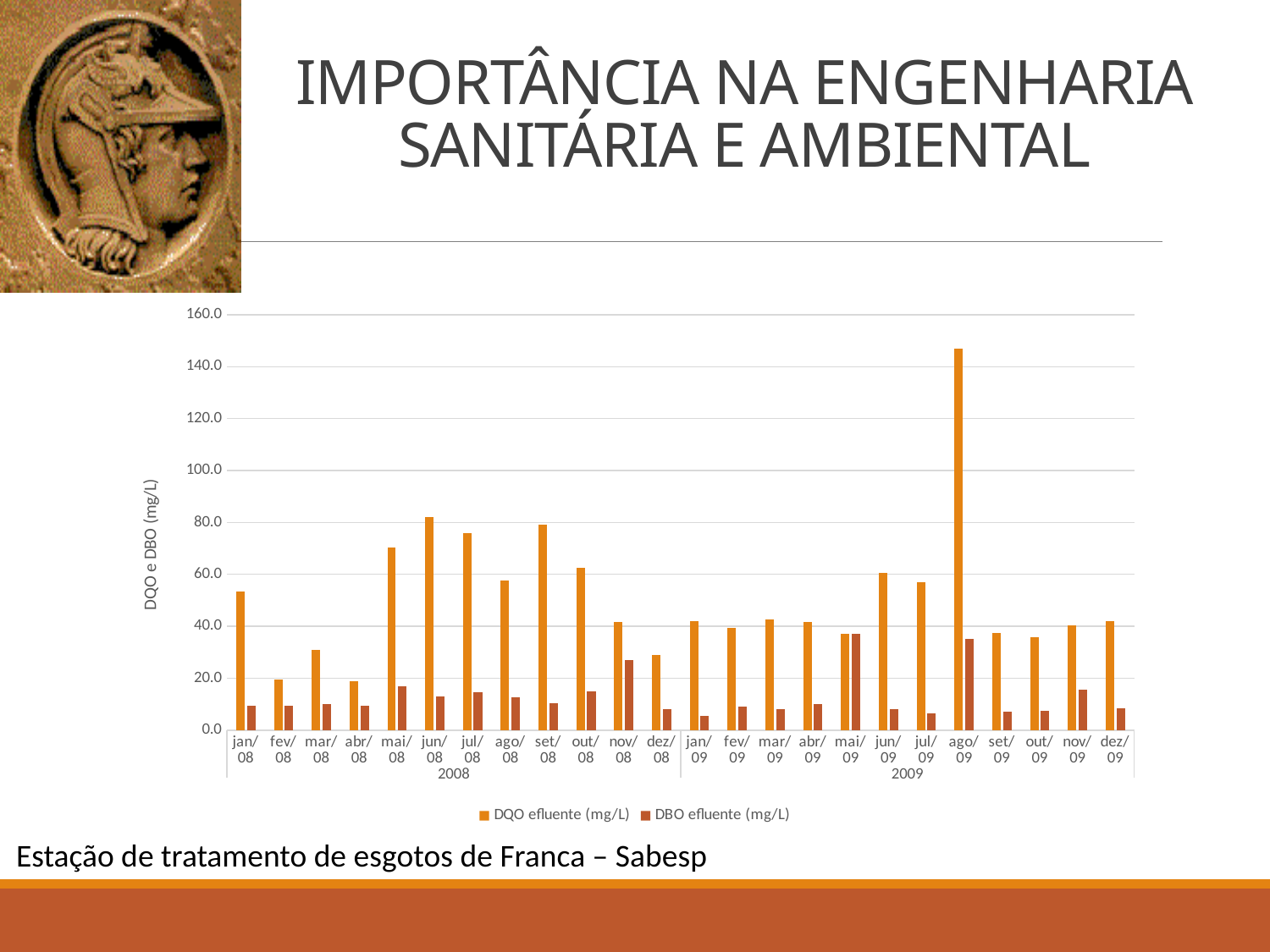
Is the DBO efluente value for nov/08 greater or less than 20? greater Is the DQO efluente value for ago/09 greater or less than 140? greater How many months are shown along the x axis? 24 How many series does the legend list? 2 Which month has the highest DQO efluente value? ago/09 Which is larger, the DBO efluente value for nov/08 or for dez/08? nov/08 Which is larger, the DQO efluente value for mai/08 or for out/08? mai/08 What are the two series named in the legend? DQO efluente (mg/L) and DBO efluente (mg/L) What kind of chart is shown on the slide? bar chart What is the label of the vertical axis? DQO e DBO (mg/L) Is the DBO efluente value for mai/09 greater or less than 40? less